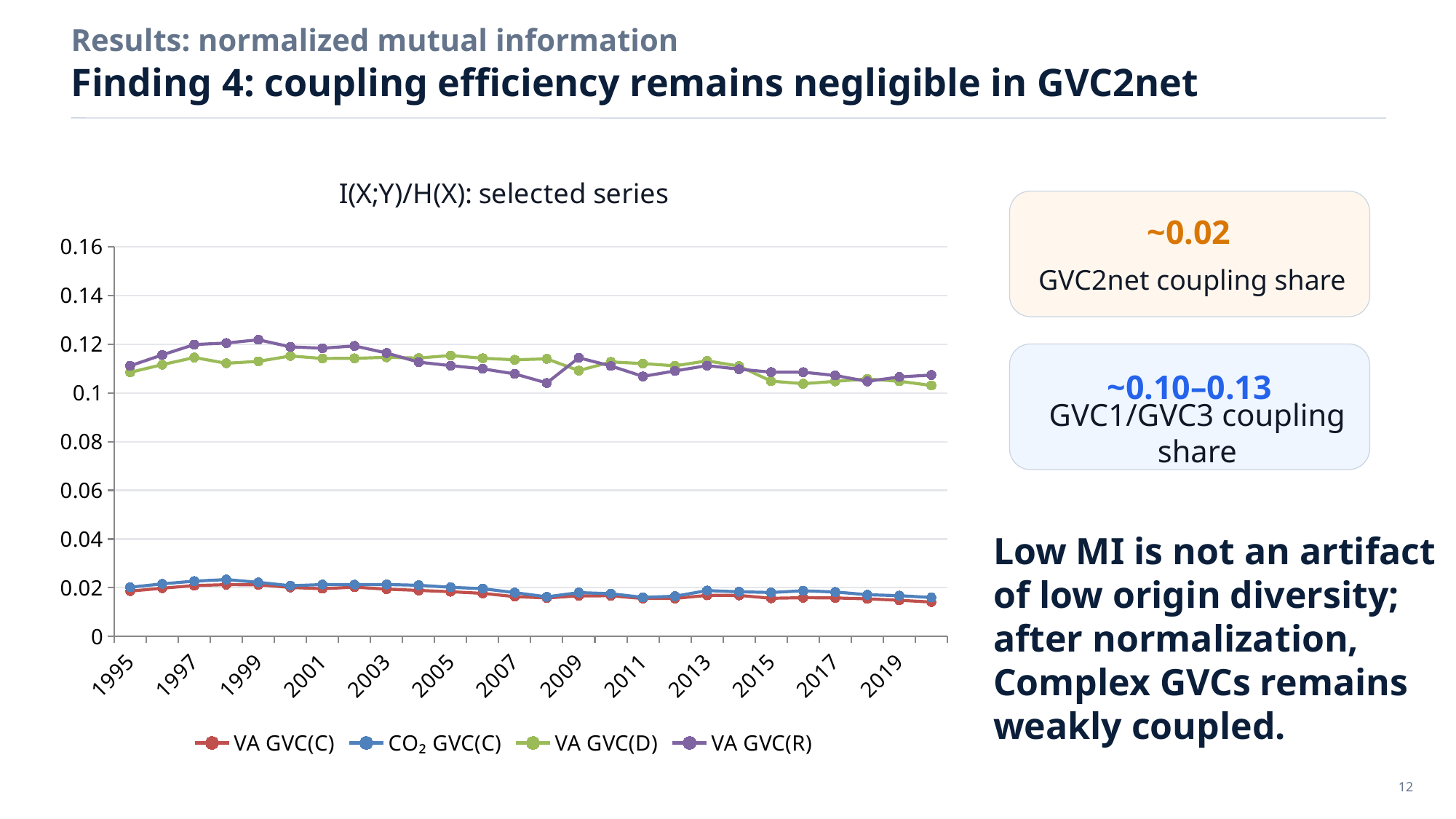
Is the value for CO₂ GVC(C) in 1995 greater or less than 0.04? less Does the VA GVC(C) series rise or fall overall from 1995 to the end of the period? fall Which series has the lowest value in 2019? VA GVC(C) Is the value for VA GVC(D) in 2019 greater or less than 0.12? less What colour is the VA GVC(D) series in the chart? green In 2009, which is larger: VA GVC(R) or VA GVC(C)? VA GVC(R) What is the title of the chart? I(X;Y)/H(X): selected series Is the value for VA GVC(R) in 1999 greater or less than 0.10? greater What kind of chart is shown on the slide? line chart How many series does the chart legend list? 4 How many year labels are shown on the x axis of the chart? 13 Which series has the highest value in 1999? VA GVC(R)